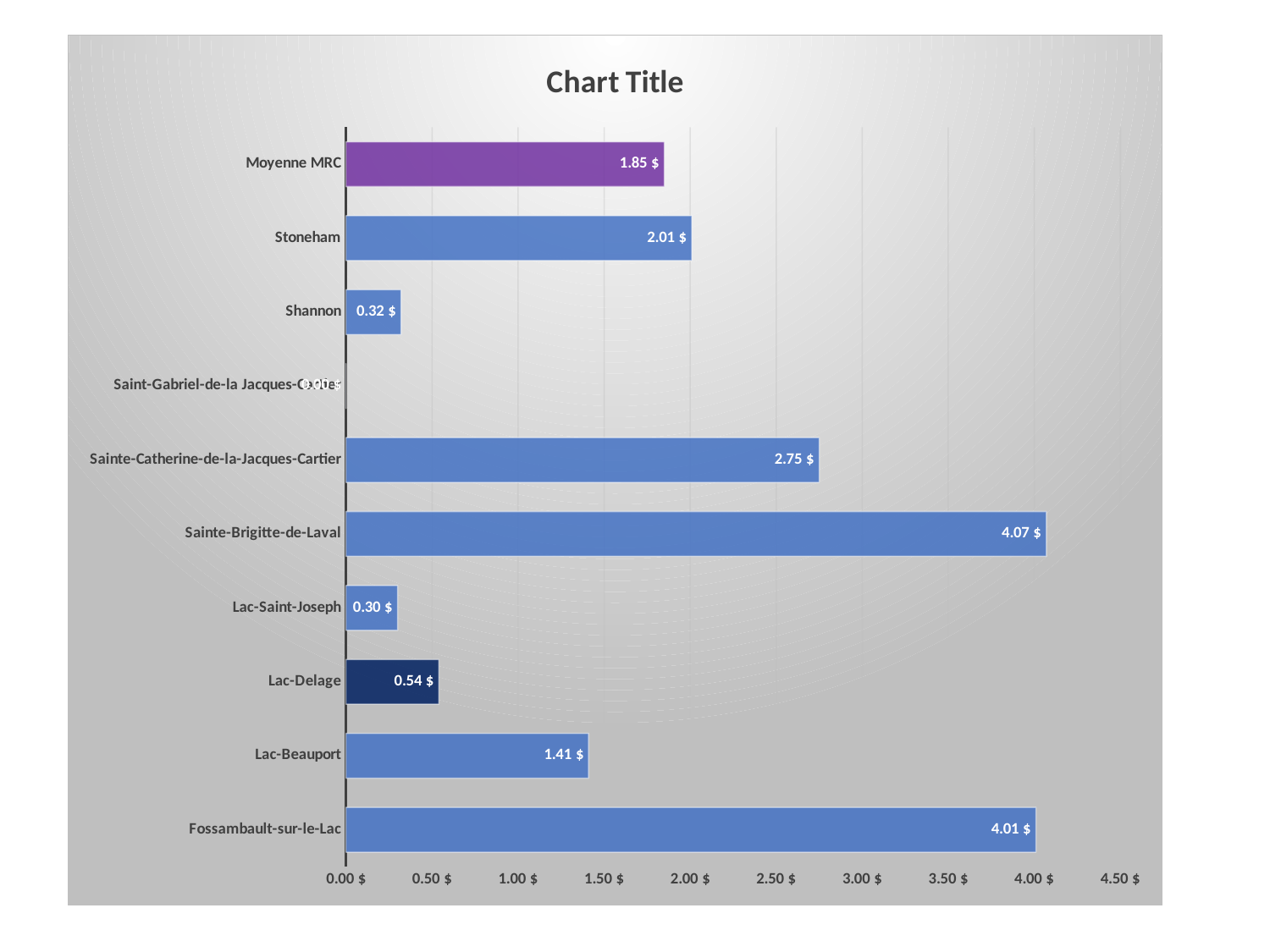
What is the value for Moyenne MRC? 1.85 $ Which category has the highest value? Sainte-Brigitte-de-Laval What kind of chart is shown on the slide? bar chart How many categories are shown on the chart? 10 Is the value for Lac-Beauport greater or less than 1.50 $? less Which is larger, the value for Sainte-Catherine-de-la-Jacques-Cartier or the value for Stoneham? Sainte-Catherine-de-la-Jacques-Cartier What is the difference between the values for Sainte-Brigitte-de-Laval and Fossambault-sur-le-Lac? 0.06 $ What is the title of the chart? Chart Title What is the value for Lac-Delage? 0.54 $ What is the difference between the values for Stoneham and Lac-Beauport? 0.60 $ What is the value for Stoneham? 2.01 $ What is the value for Sainte-Catherine-de-la-Jacques-Cartier? 2.75 $